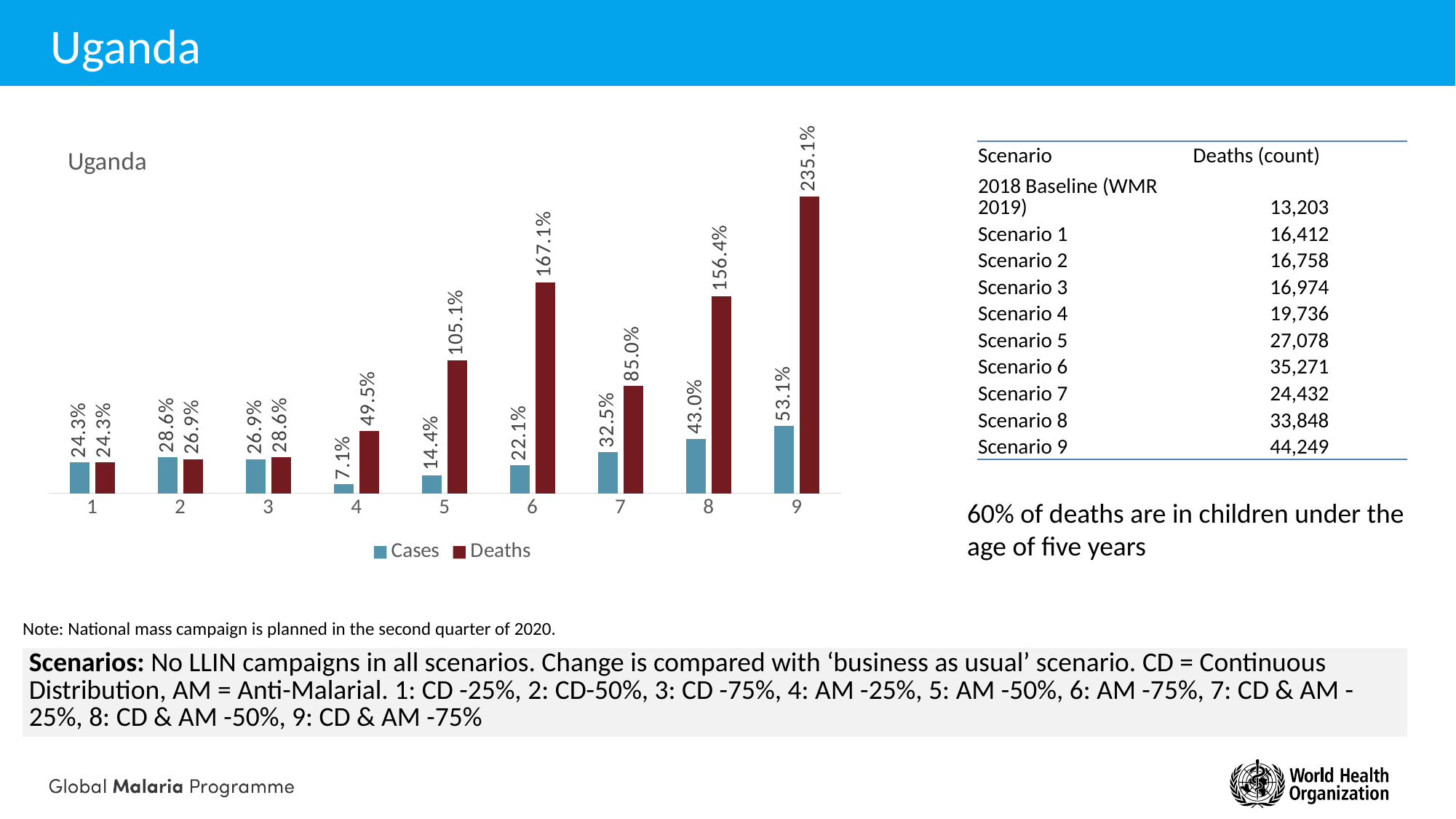
What is the Cases value for scenario 8? 43.0% What is the Deaths value for scenario 9? 235.1% What kind of chart is shown on the slide? Bar chart What is the Cases value for scenario 4? 7.1% What is the Deaths value for scenario 6? 167.1% What colour are the Deaths bars in the chart? Dark red What is the difference between the Deaths and Cases values for scenario 5? 90.7% Which is larger for scenario 2: the Cases value or the Deaths value? Cases How many scenarios are shown on the x axis of the chart? 9 How many series does the chart legend list? 2 Which scenario has the highest Deaths value? 9 Which scenario has the lowest Cases value? 4